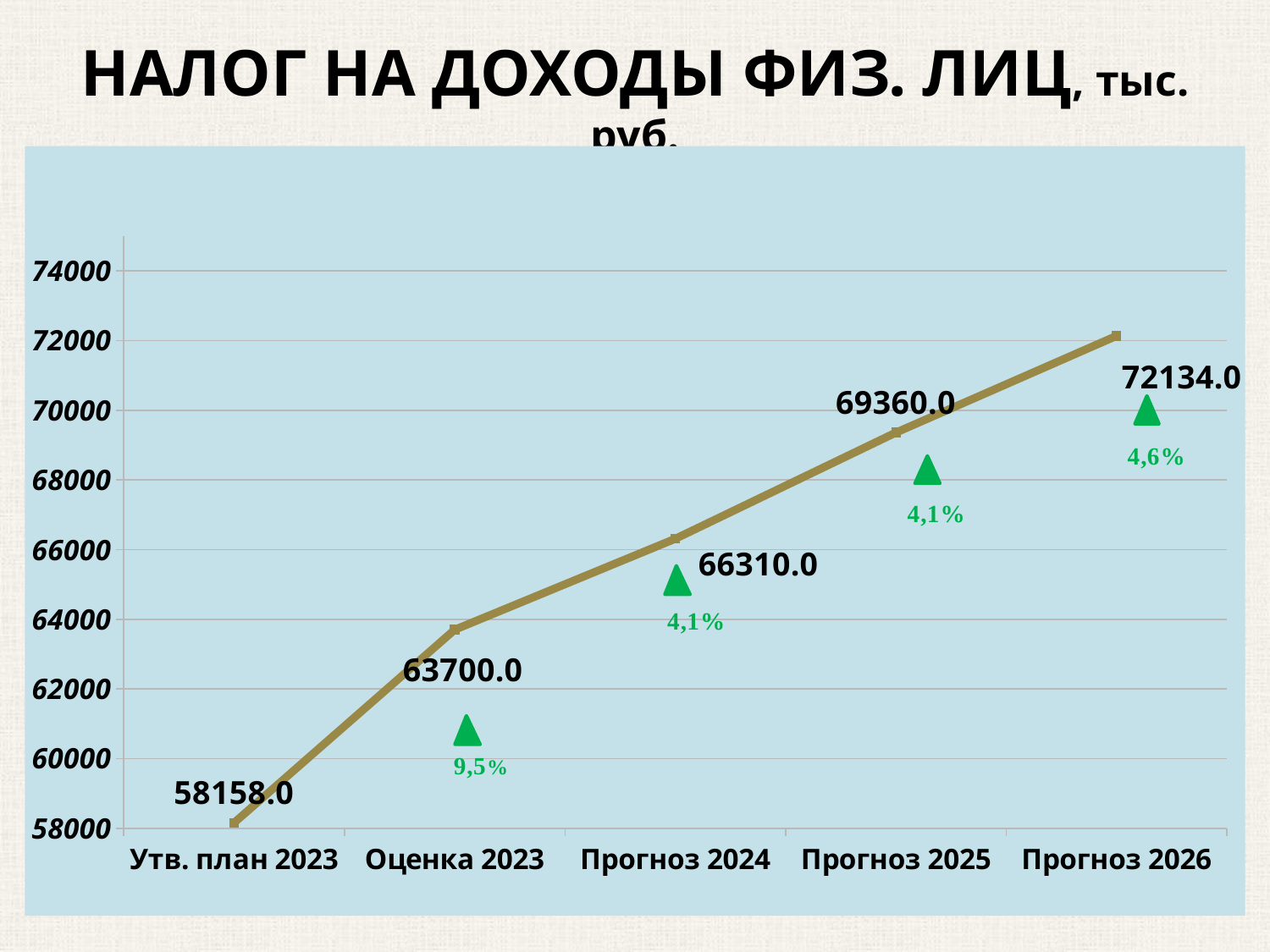
What kind of chart is shown on the slide? line chart How many data points are plotted on the chart? 5 What is the difference between the values for Оценка 2023 and Утв. план 2023? 5542.0 Which category has the lowest value? Утв. план 2023 What is the value for Утв. план 2023? 58158.0 What is the value for Прогноз 2025? 69360.0 What is the difference between the values for Прогноз 2026 and Прогноз 2025? 2774.0 Which category has the highest value? Прогноз 2026 Do the values rise or fall from Утв. план 2023 to Прогноз 2026? rise Which is larger, the value for Прогноз 2024 or the value for Оценка 2023? Прогноз 2024 Is the value for Прогноз 2024 greater or less than 68000? less What is the value for Оценка 2023? 63700.0